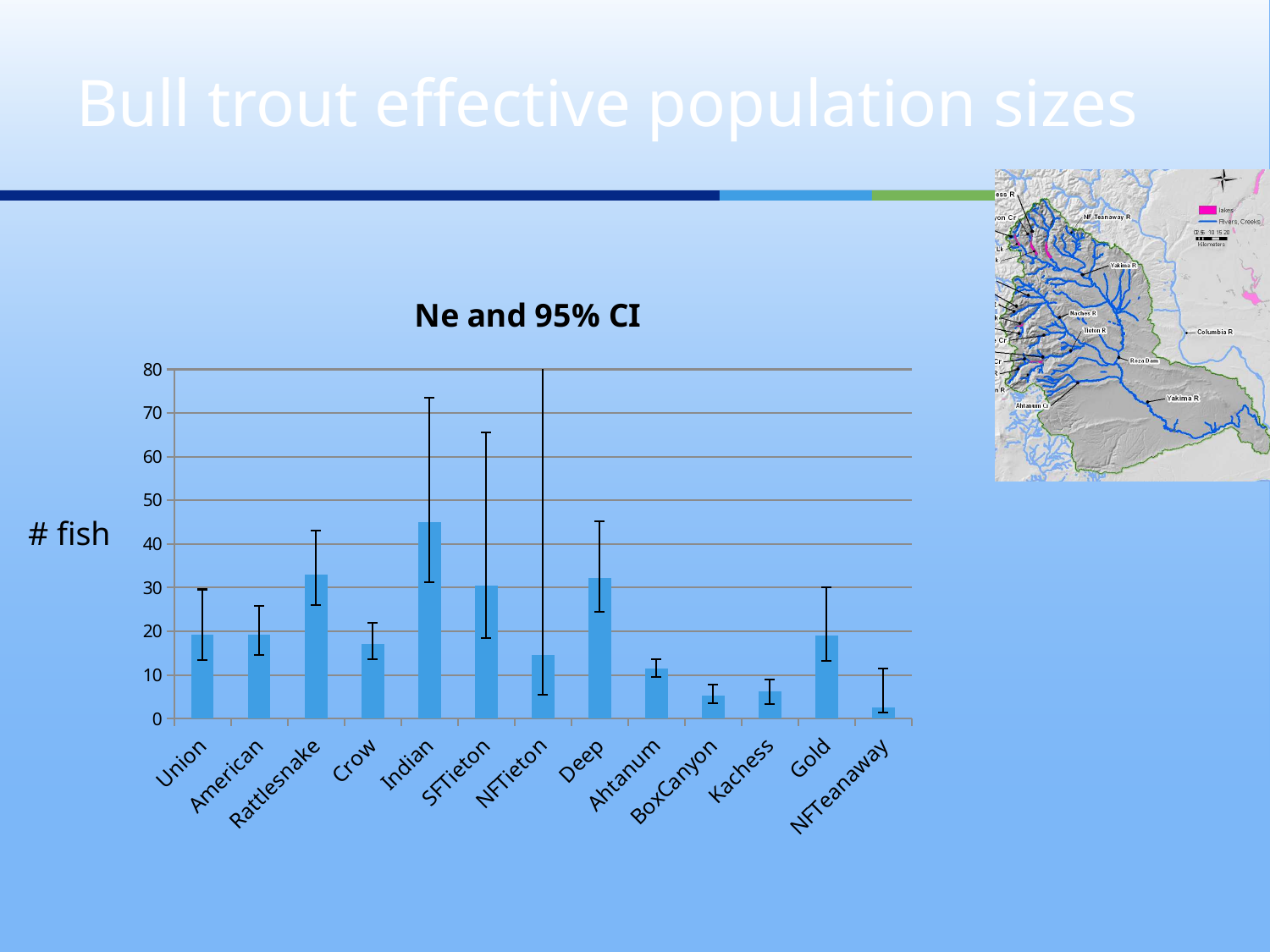
What label is shown on the vertical axis of the chart? # fish How many populations (categories) are plotted on the x axis? 13 Is the Ne value for BoxCanyon greater or less than 10? less What is the title of the chart? Ne and 95% CI Which population has the lowest Ne value? NFTeanaway Is the Ne value for NFTieton greater or less than 20? less Which has the larger Ne value, Crow or Ahtanum? Crow Is the Ne value for Indian greater or less than 40? greater What type of chart is shown on the slide? bar chart Which population has the highest Ne value? Indian Which has the larger Ne value, Indian or Rattlesnake? Indian